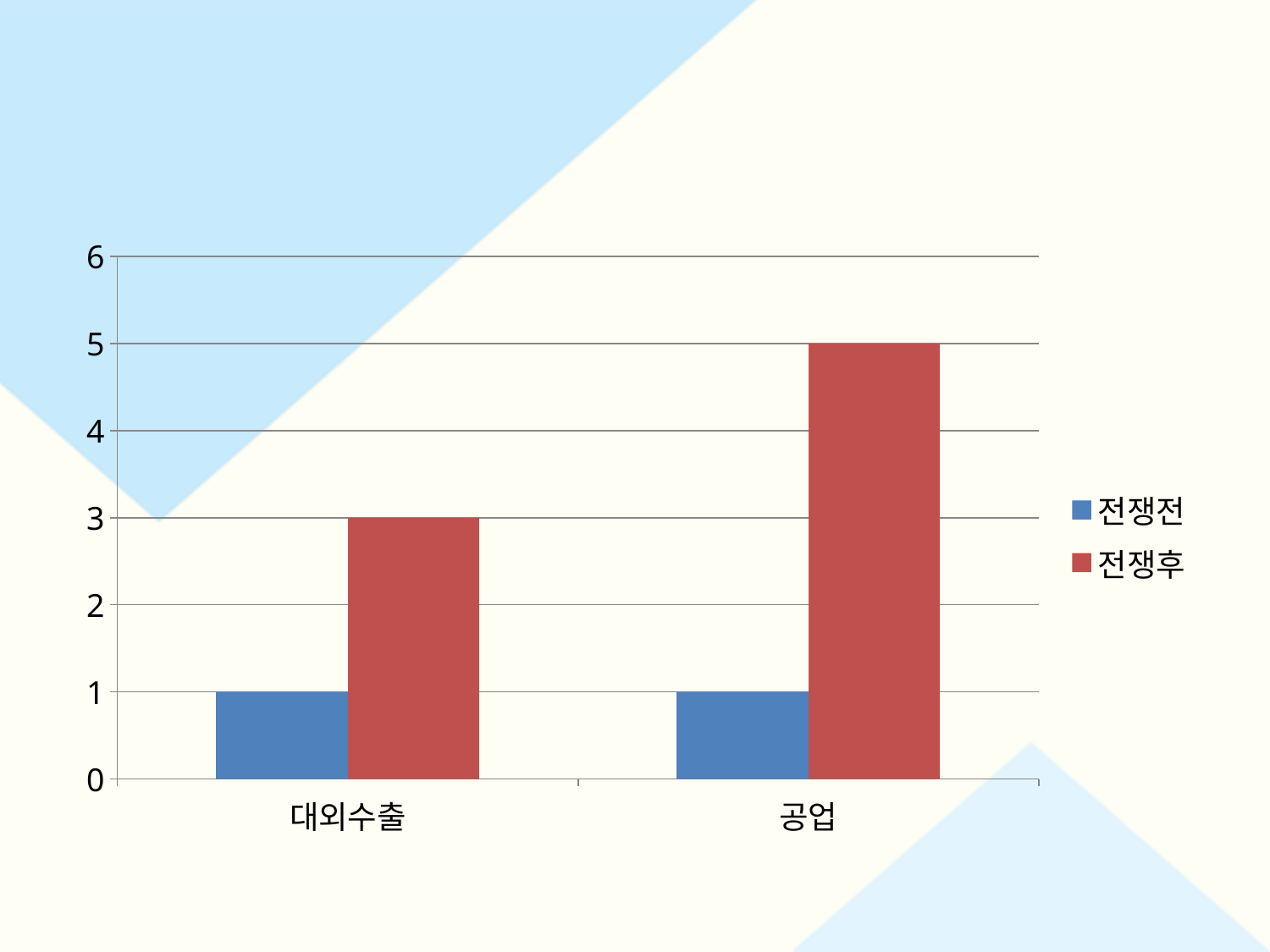
What is the value of 전쟁후 for 대외수출? 3 What is the difference between the 전쟁후 and 전쟁전 values for 공업? 4 What is the value of 전쟁전 for 공업? 1 Which is larger for 대외수출: 전쟁전 or 전쟁후? 전쟁후 How many series does the legend list? 2 Which category has the highest 전쟁후 value? 공업 What kind of chart is shown on the slide? bar chart How many categories are shown on the x axis? 2 What is the value of 전쟁전 for 대외수출? 1 What is the difference between the 전쟁후 values for 공업 and 대외수출? 2 What is the value of 전쟁후 for 공업? 5 Which category has the lowest 전쟁후 value? 대외수출